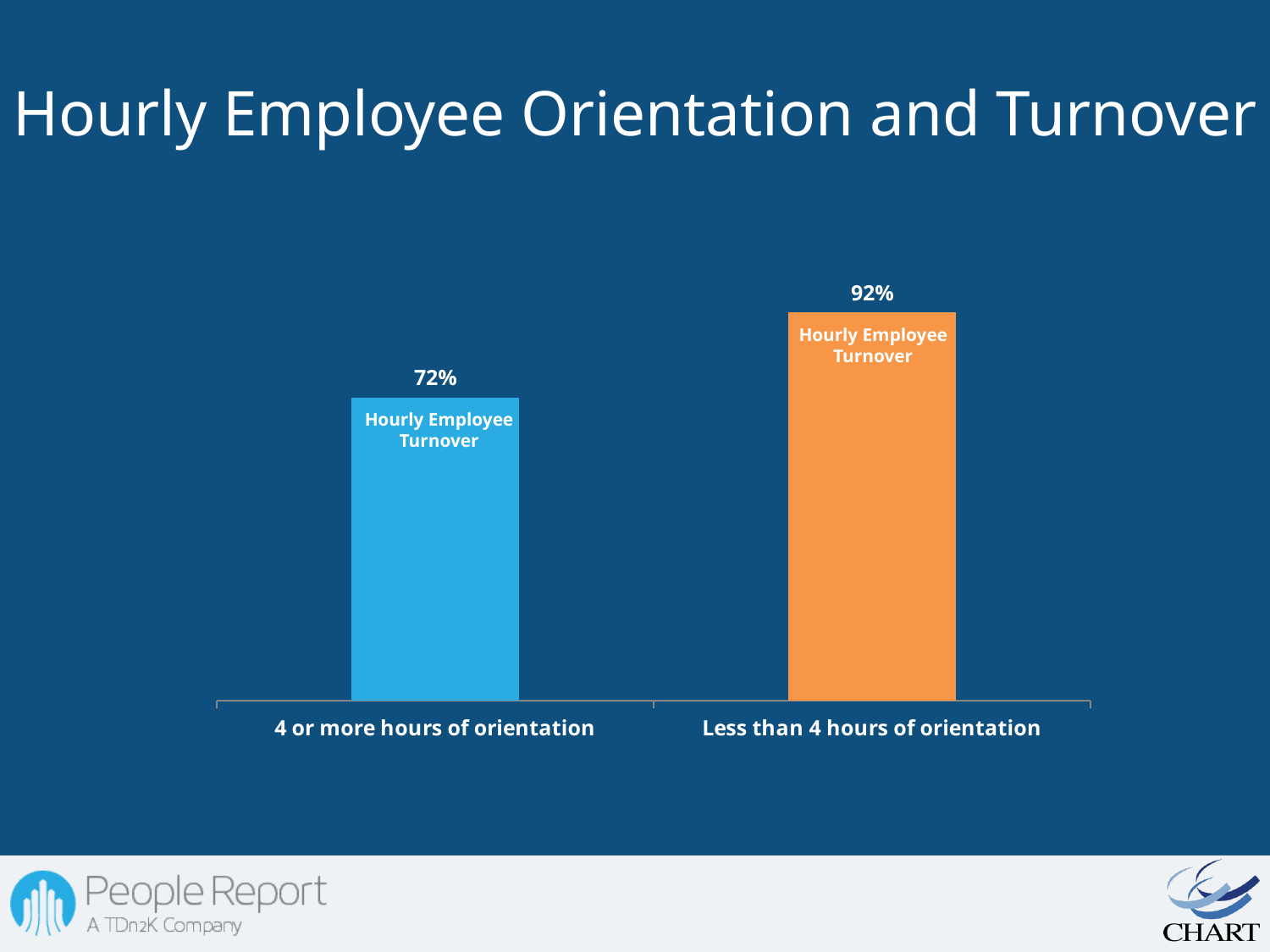
How many categories are shown on the x axis of the chart? 2 What kind of chart is shown on the slide? Bar chart What is the hourly employee turnover for 4 or more hours of orientation? 72% Is hourly employee turnover larger for 4 or more hours of orientation or for less than 4 hours of orientation? Less than 4 hours of orientation What is the hourly employee turnover for less than 4 hours of orientation? 92% What label is printed inside each bar? Hourly Employee Turnover What is the difference in hourly employee turnover between less than 4 hours of orientation and 4 or more hours of orientation? 20% Which orientation category has the higher hourly employee turnover? Less than 4 hours of orientation Which orientation category has the lower hourly employee turnover? 4 or more hours of orientation What is the title of the slide? Hourly Employee Orientation and Turnover What colour is the bar for less than 4 hours of orientation? Orange